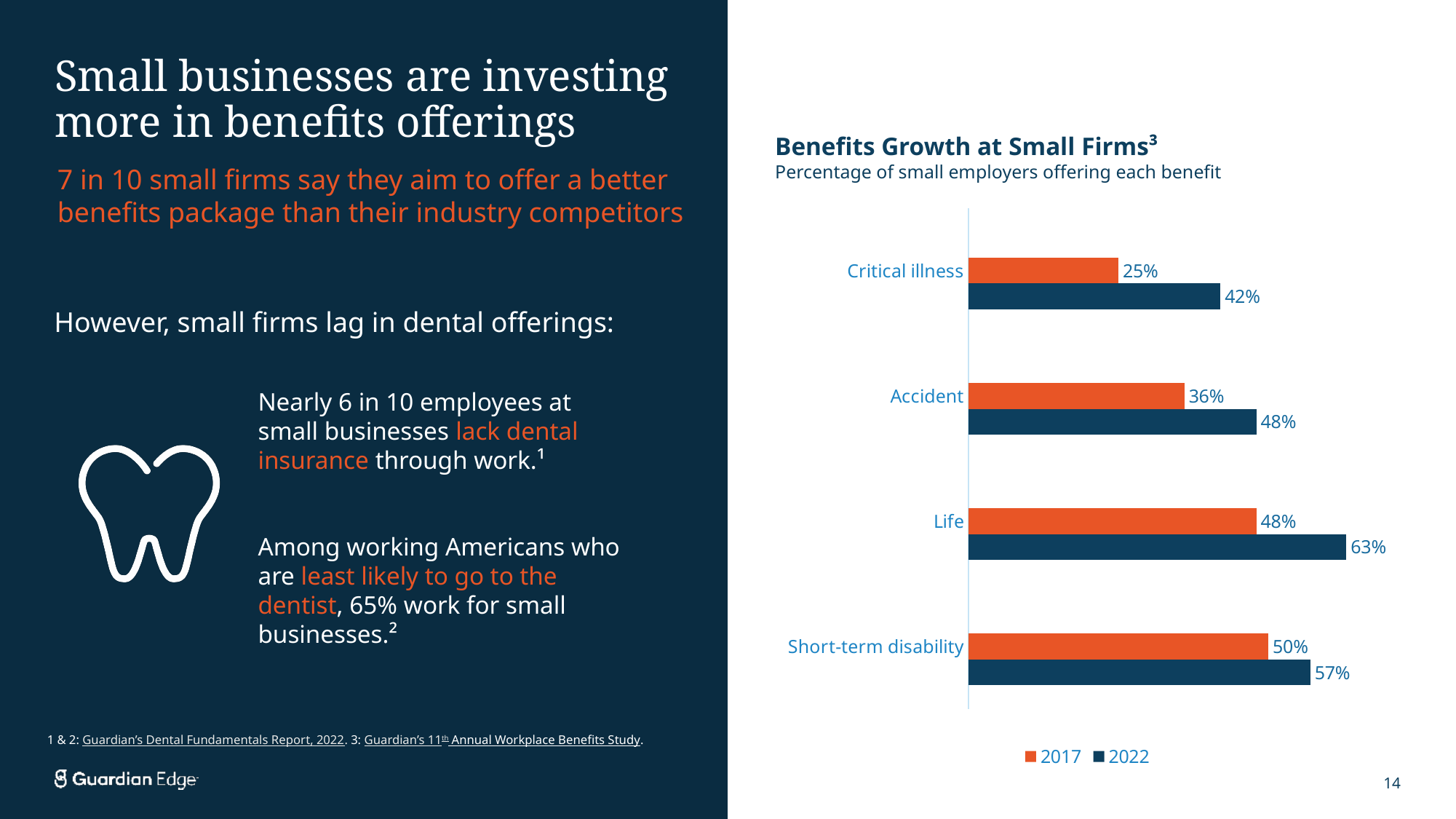
How many series does the legend list? 2 What percentage of small employers offered accident benefits in 2017? 36% Which benefit has the lowest 2017 value? Critical illness Which benefit has the highest 2022 value? Life What is the difference between the 2022 and 2017 values for Short-term disability? 7 percentage points By how many percentage points did the share of small employers offering critical illness benefits grow from 2017 to 2022? 17 percentage points What is the 2022 value for Life? 63% Which colour represents the 2017 series in the chart? Orange What type of chart is used to show Benefits Growth at Small Firms? Bar chart What percentage of small employers offered critical illness benefits in 2022? 42% Which is larger: the 2017 value for Life or the 2022 value for Critical illness? 2017 value for Life How many benefit categories are shown in the chart? 4